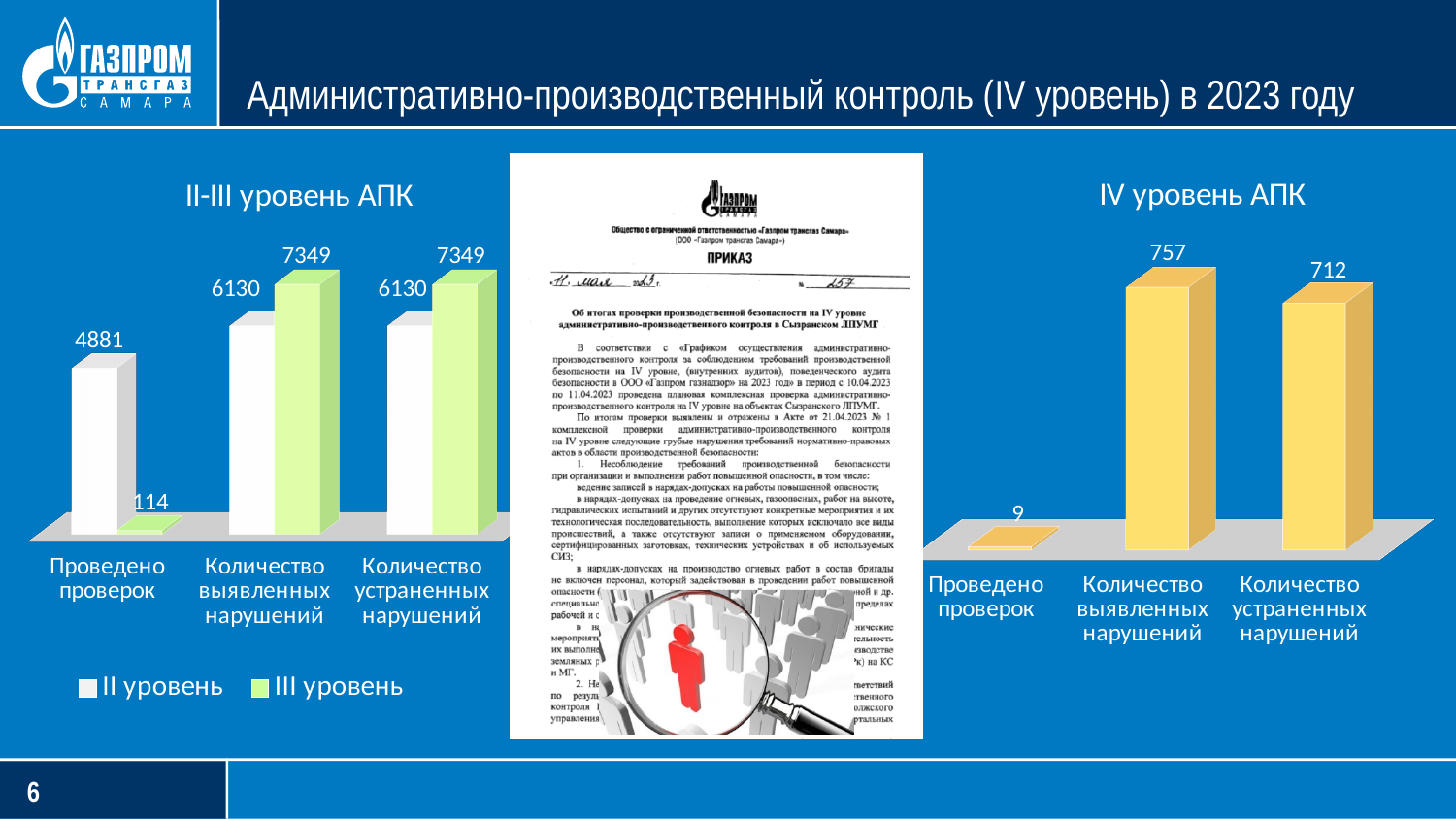
In the 'II-III уровень АПК' chart, what is the value for 'II уровень' in the 'Проведено проверок' category? 4881 In the 'IV уровень АПК' chart, what is the difference between 'Количество выявленных нарушений' and 'Количество устраненных нарушений'? 45 In the 'II-III уровень АПК' chart, what is the difference between the 'III уровень' and 'II уровень' values for 'Количество устраненных нарушений'? 1219 In the 'IV уровень АПК' chart, what is the value for 'Проведено проверок'? 9 In the 'II-III уровень АПК' chart, what colour represents 'III уровень'? Green In the 'II-III уровень АПК' chart, which is larger for 'Проведено проверок': 'II уровень' or 'III уровень'? II уровень What type of chart is the 'IV уровень АПК' chart? Bar chart In the 'IV уровень АПК' chart, what is the value for 'Количество выявленных нарушений'? 757 In the 'IV уровень АПК' chart, which category has the highest value? Количество выявленных нарушений In the 'II-III уровень АПК' chart, what is the value for 'III уровень' in the 'Количество выявленных нарушений' category? 7349 How many series does the legend of the 'II-III уровень АПК' chart list? 2 In the 'II-III уровень АПК' chart, what is the value for 'III уровень' in the 'Проведено проверок' category? 114